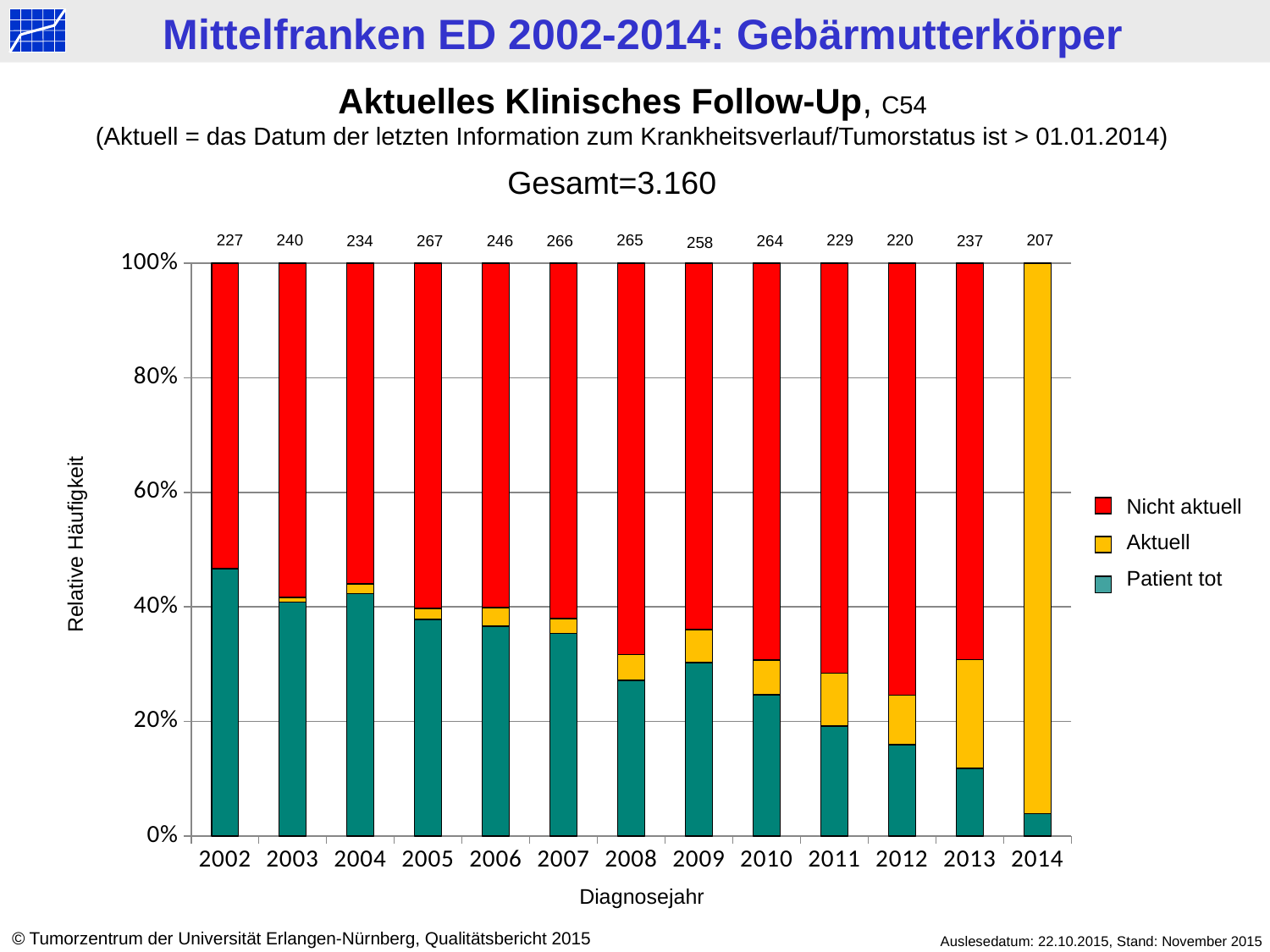
Does the 'Patient tot' share rise or fall from 2002 to 2014? fall Is the 'Patient tot' share for 2013 greater or less than 20%? less What is the number printed above the bar for 2009? 258 Is the 'Patient tot' share for 2002 greater or less than 40%? greater What is the difference between the numbers printed above the bars for 2003 and 2002? 13 Which has the larger number printed above its bar, 2010 or 2011? 2010 Which diagnosis year has the lowest number printed above its bar? 2014 What is the number printed above the bar for 2014? 207 Which diagnosis year has the highest number printed above its bar? 2005 How many diagnosis years are shown on the x axis? 13 How many series does the legend list? 3 What is the number printed above the bar for 2005? 267